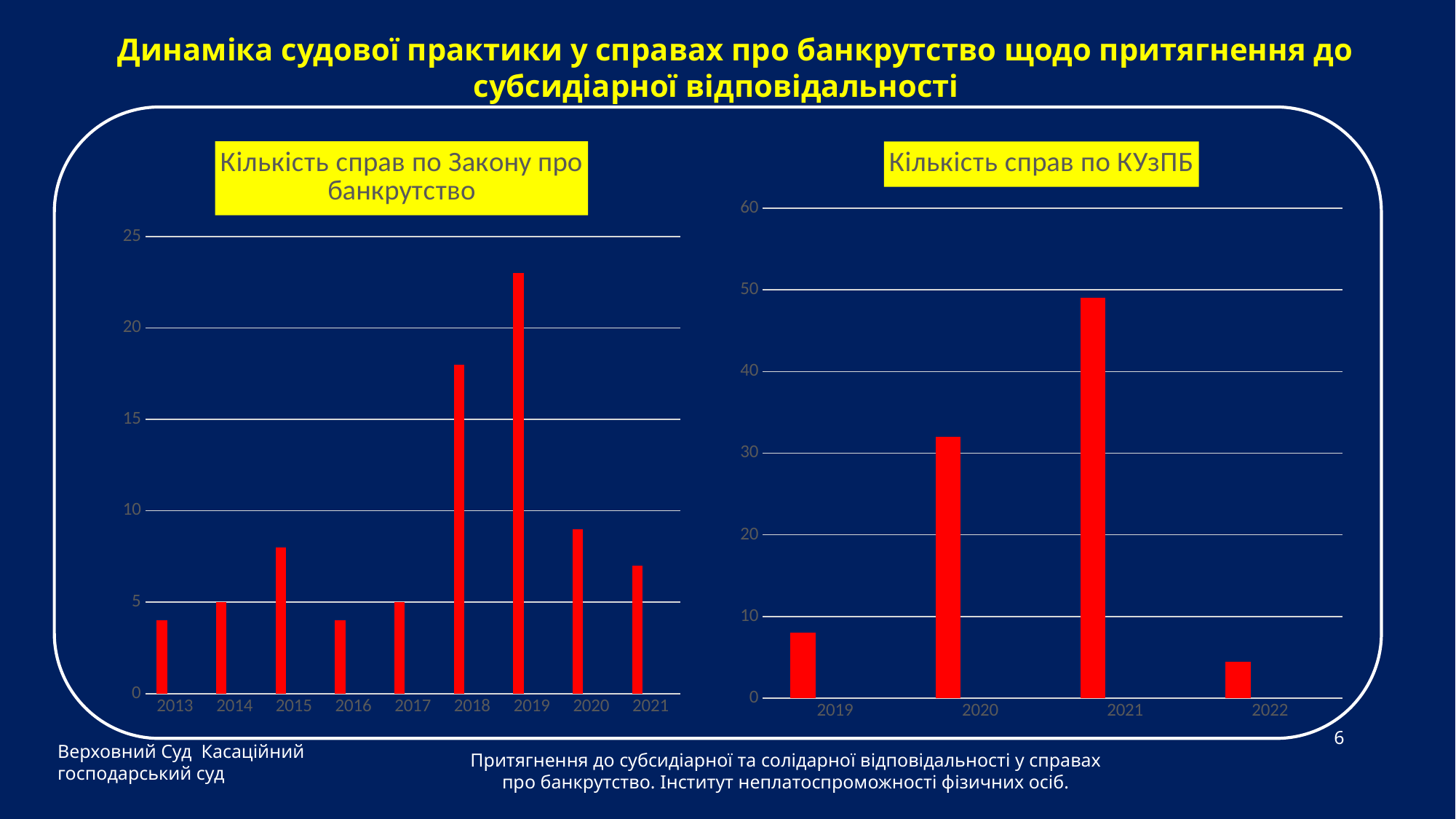
In the left chart, "Кількість справ по Закону про банкрутство", which year has the highest value? 2019 In the right chart, "Кількість справ по КУзПБ", which year has the highest value? 2021 In the left chart, "Кількість справ по Закону про банкрутство", is the value for 2020 greater or less than 10? less In the right chart, "Кількість справ по КУзПБ", which year has the lowest value? 2022 How many years are shown on the x axis of the left chart, "Кількість справ по Закону про банкрутство"? 9 In the left chart, "Кількість справ по Закону про банкрутство", is the value for 2019 greater or less than 20? greater In the right chart, "Кількість справ по КУзПБ", is the value for 2021 greater or less than 40? greater How many years are shown on the x axis of the right chart, "Кількість справ по КУзПБ"? 4 What kind of chart is the left chart, "Кількість справ по Закону про банкрутство"? bar chart In the left chart, "Кількість справ по Закону про банкрутство", which is larger, the value for 2015 or the value for 2016? 2015